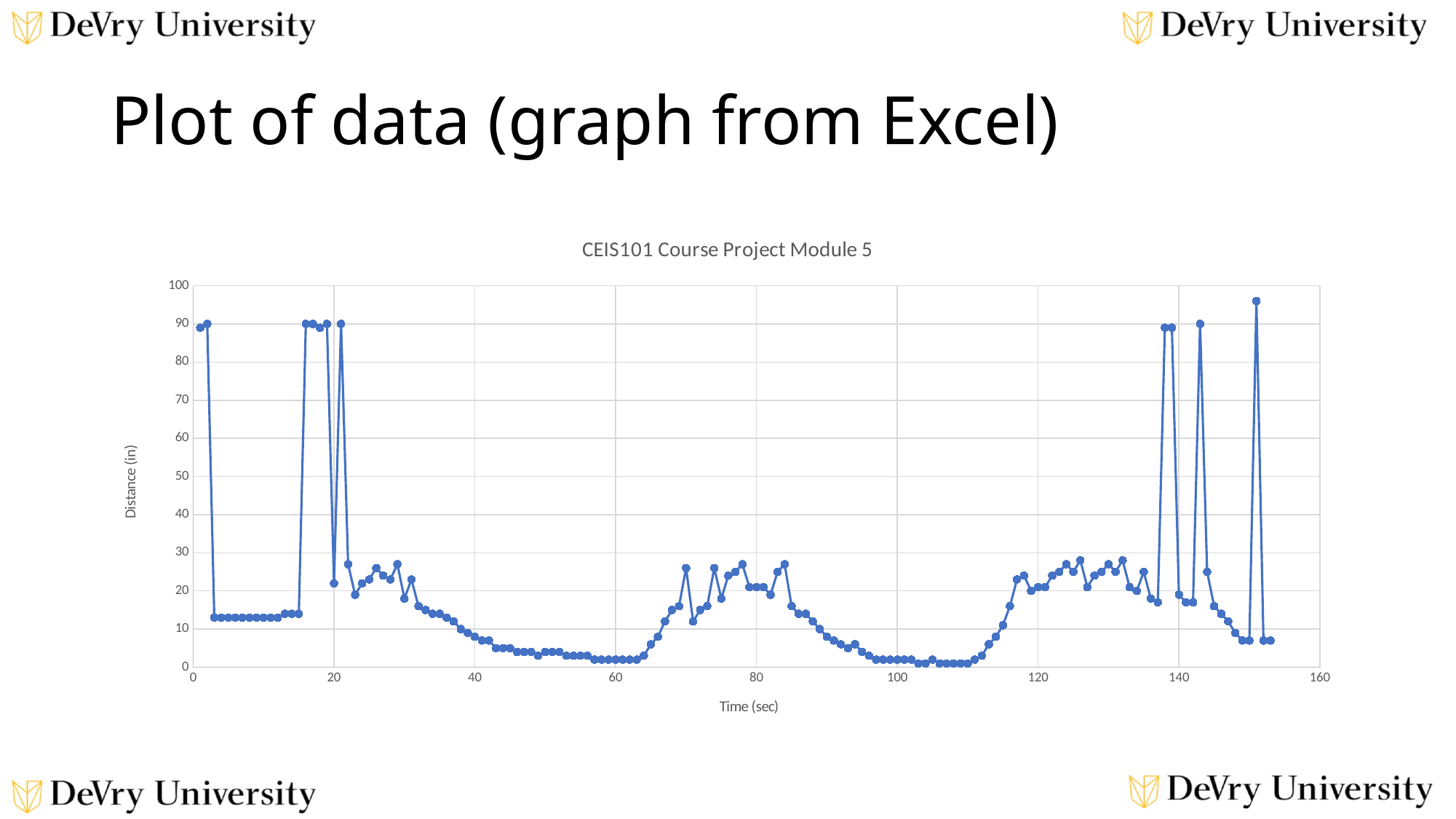
Is the value at time 60 sec greater or less than 10? less Is the value at time 0 sec greater or less than 80? greater What is the title of the chart? CEIS101 Course Project Module 5 Which is larger, the value at time 0 sec or the value at time 60 sec? time 0 sec Is the value at time 100 sec greater or less than 10? less What kind of chart is shown on the slide? line chart What is the label of the y axis of the chart? Distance (in) Is the highest point on the chart located before or after 140 sec on the x axis? after Between about 30 sec and 60 sec, do the values generally rise or fall along the x axis? fall Which is larger, the value at time 80 sec or the value at time 100 sec? time 80 sec